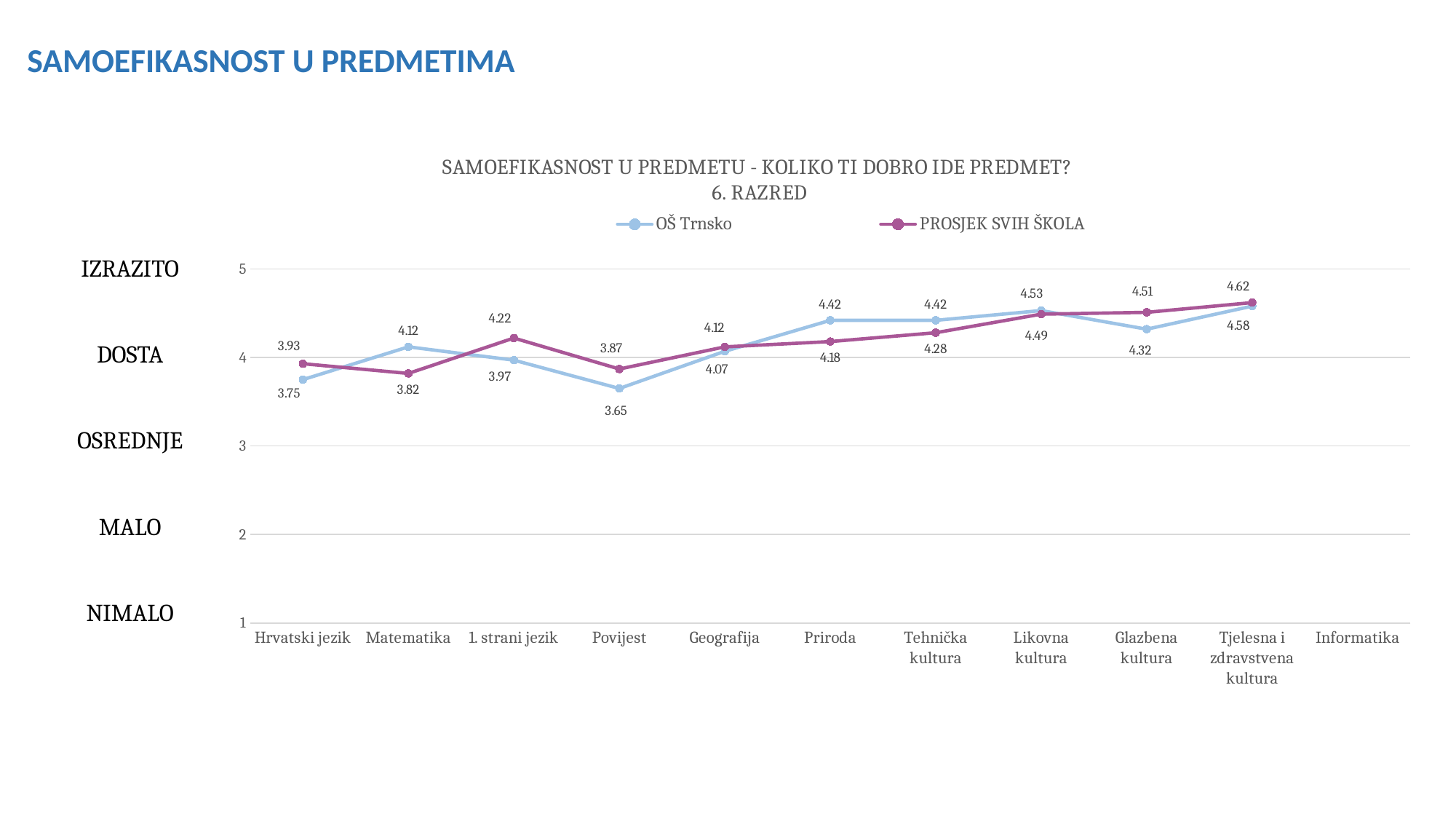
What is the PROSJEK SVIH ŠKOLA value for 1. strani jezik? 4.22 What is the OŠ Trnsko value for Likovna kultura? 4.53 For Priroda, which series has the larger value, OŠ Trnsko or PROSJEK SVIH ŠKOLA? OŠ Trnsko What kind of chart is shown on the slide? line chart What is the OŠ Trnsko value for Povijest? 3.65 Which subject has the highest PROSJEK SVIH ŠKOLA value? Tjelesna i zdravstvena kultura What is the difference between the OŠ Trnsko and PROSJEK SVIH ŠKOLA values for Matematika? 0.30 How many series does the legend list? 2 Which subject has the lowest OŠ Trnsko value? Povijest Which subject has the lowest PROSJEK SVIH ŠKOLA value? Matematika Is the OŠ Trnsko value for Hrvatski jezik greater or less than 4? less How many subjects are labelled on the x axis? 11